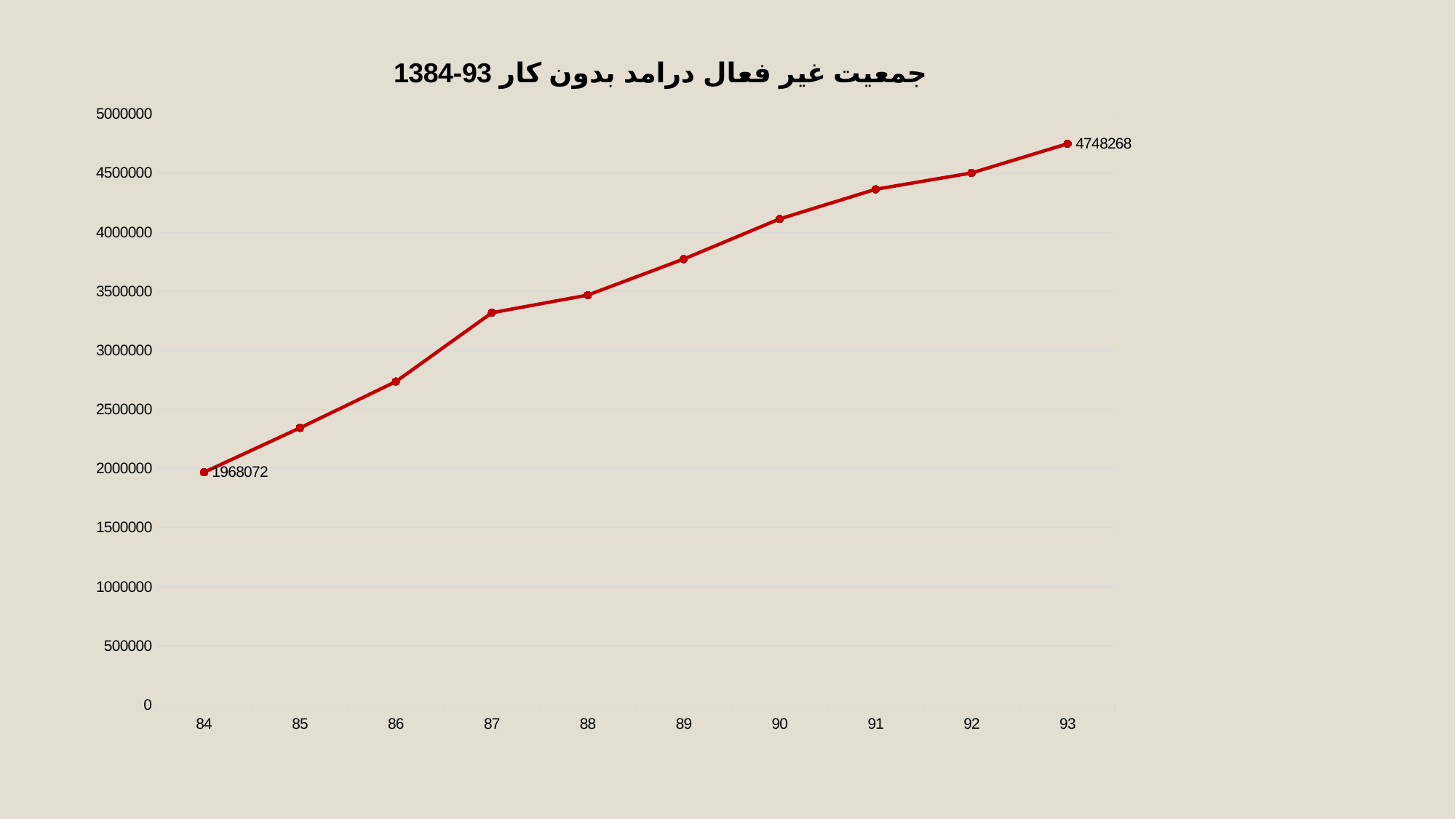
Is the value for 91 greater or less than 4500000? less What is the value for 93? 4748268 Which year has the highest value? 93 What is the difference between the value for 93 and the value for 84? 2780196 Which is larger, the value for 87 or the value for 85? 87 What type of chart is shown on the slide? line chart How many data points are plotted on the line? 10 Which year has the lowest value? 84 What is the title of the chart? جمعیت غیر فعال درامد بدون کار 1384-93 Do the values rise or fall from 84 to 93? rise Is the value for 86 greater or less than 2500000? greater What is the value for 84? 1968072